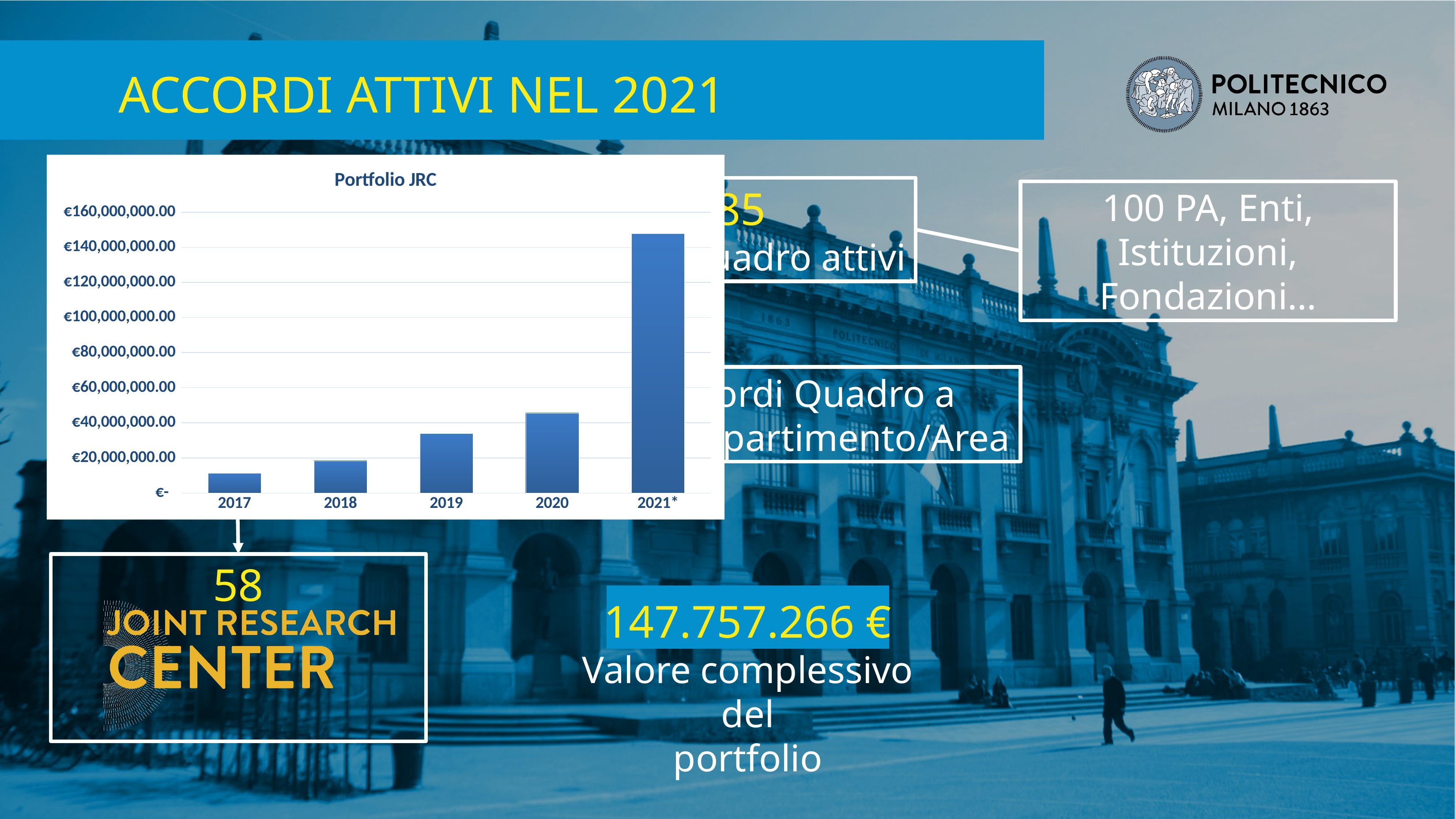
Which year has the highest value in the Portfolio JRC chart? 2021* Do the values in the Portfolio JRC chart rise or fall from 2017 to 2021*? rise Is the value for 2020 greater or less than €60,000,000.00? less Which year has the larger value, 2019 or 2020? 2020 Is the value for 2017 greater or less than €20,000,000.00? less Is the value for 2021* greater or less than €120,000,000.00? greater What is the title of the chart? Portfolio JRC How many years are plotted on the x axis of the Portfolio JRC chart? 5 Which year has the lowest value in the Portfolio JRC chart? 2017 What type of chart is shown on the slide? bar chart Which x-axis label in the chart is marked with an asterisk? 2021*